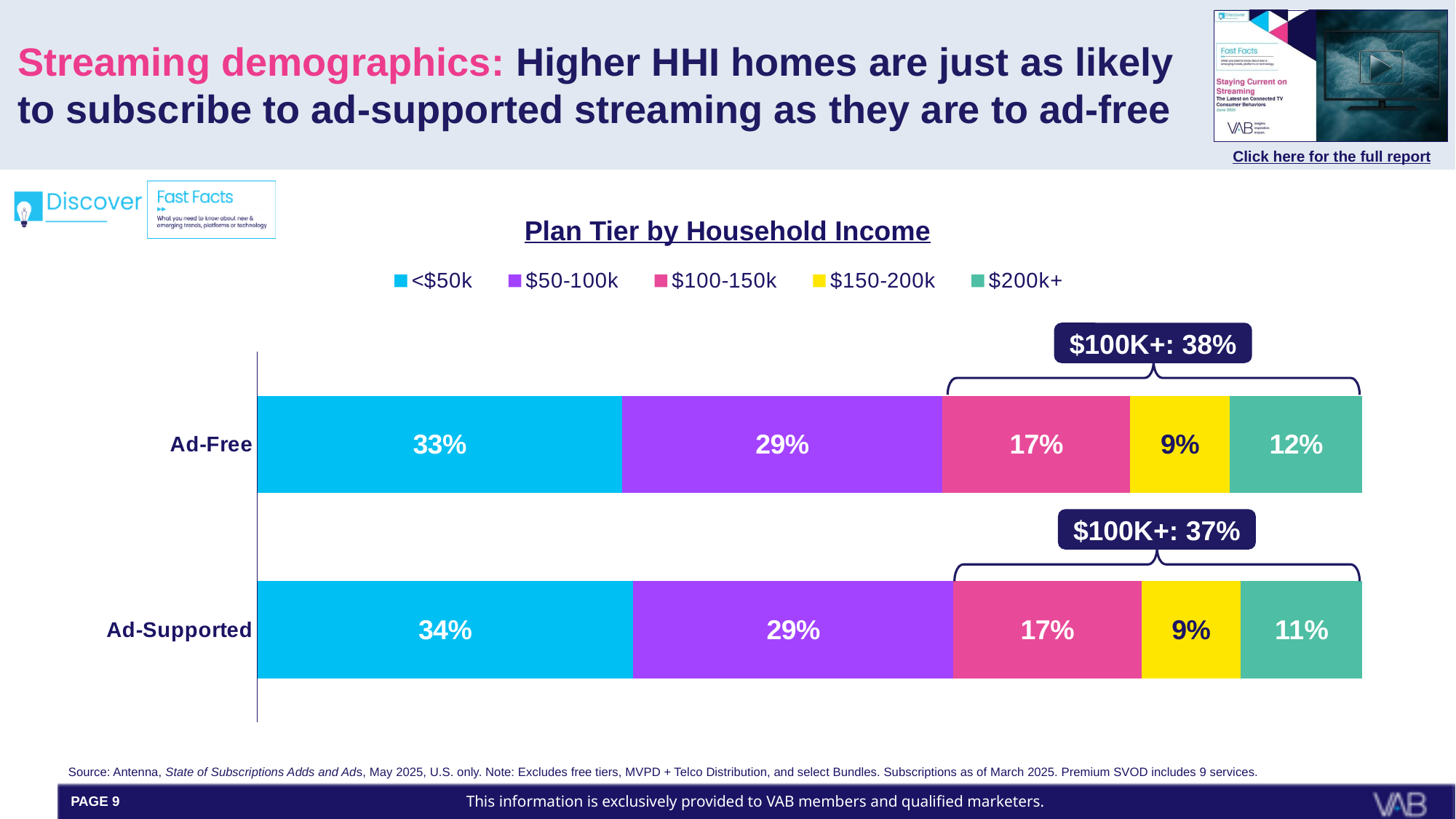
Which is larger: the $200k+ value for Ad-Free or for Ad-Supported? Ad-Free What is the value for the $150-200k segment of the Ad-Supported bar? 9% How many series does the legend list? 5 What is the value for the <$50k segment of the Ad-Free bar? 33% What is the difference between the <$50k values for Ad-Supported and Ad-Free? 1% Which income segment is the largest in the Ad-Free bar? <$50k What is the value for the $200k+ segment of the Ad-Supported bar? 11% What is the value for the $200k+ segment of the Ad-Free bar? 12% What is the value for the <$50k segment of the Ad-Supported bar? 34% What kind of chart is shown on the slide? Stacked bar chart What is the title of the chart? Plan Tier by Household Income Which income segment is the smallest in the Ad-Supported bar? $150-200k